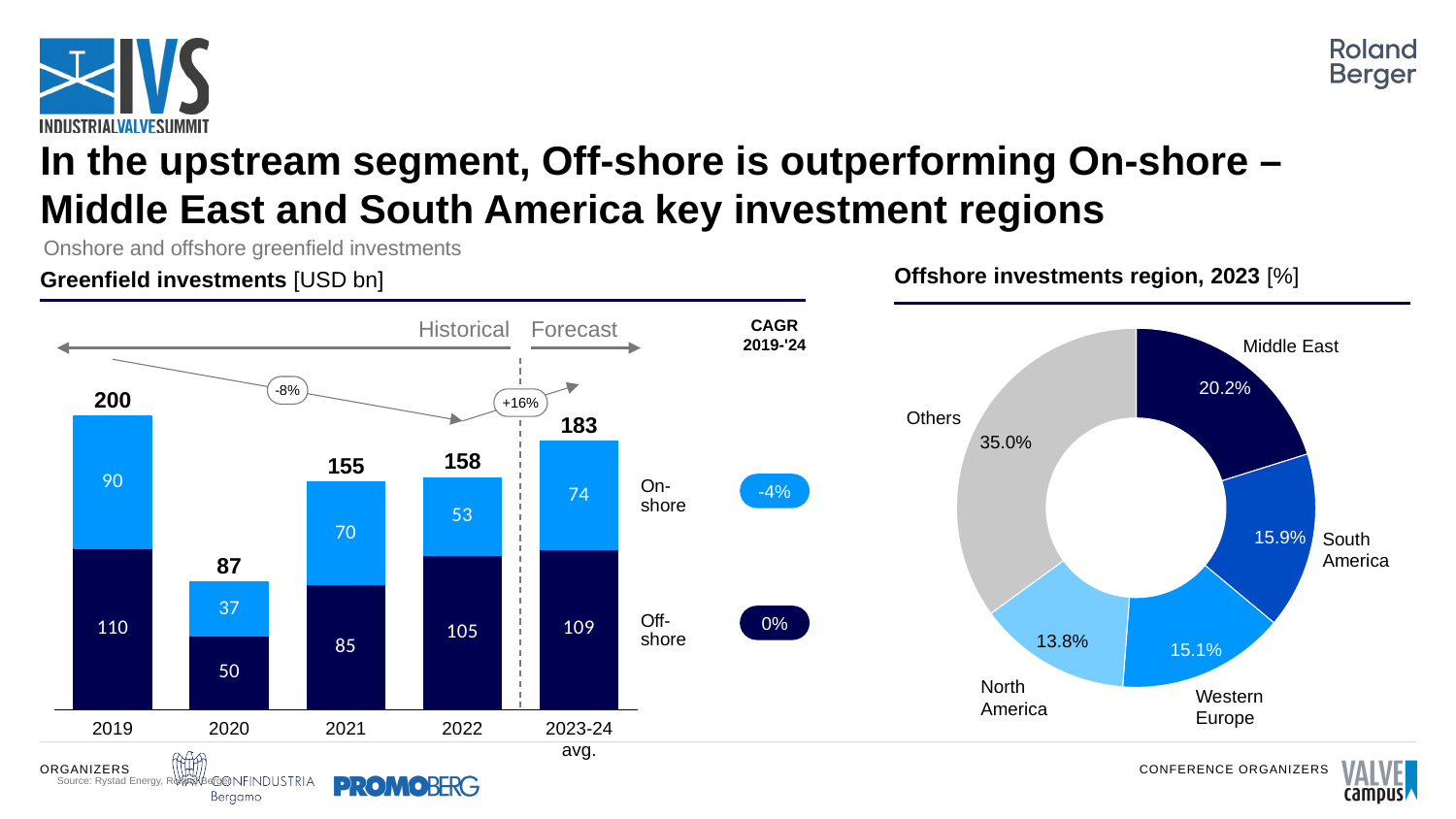
In the Greenfield investments chart, what is the total for 2023-24 avg.? 183 In the Offshore investments region, 2023 chart, what share does the Middle East have? 20.2% In the Greenfield investments chart, what is the CAGR 2019-'24 shown for On-shore? -4% In the Greenfield investments chart, which year has the lowest total greenfield investment? 2020 In the Offshore investments region, 2023 chart, which named region (excluding Others) has the smallest share? North America In the Offshore investments region, 2023 chart, what is the difference between the South America and Western Europe shares? 0.8% In the Greenfield investments chart, what is the difference between the Off-shore values for 2022 and 2021? 20 What type of chart is the Greenfield investments chart? Stacked bar chart In the Greenfield investments chart, what is the Off-shore value for 2019? 110 In the Greenfield investments chart, which is larger in 2021: the On-shore value or the Off-shore value? Off-shore In the Greenfield investments chart, how many bars (periods) are shown? 5 In the Greenfield investments chart, what is the On-shore value for 2022? 53